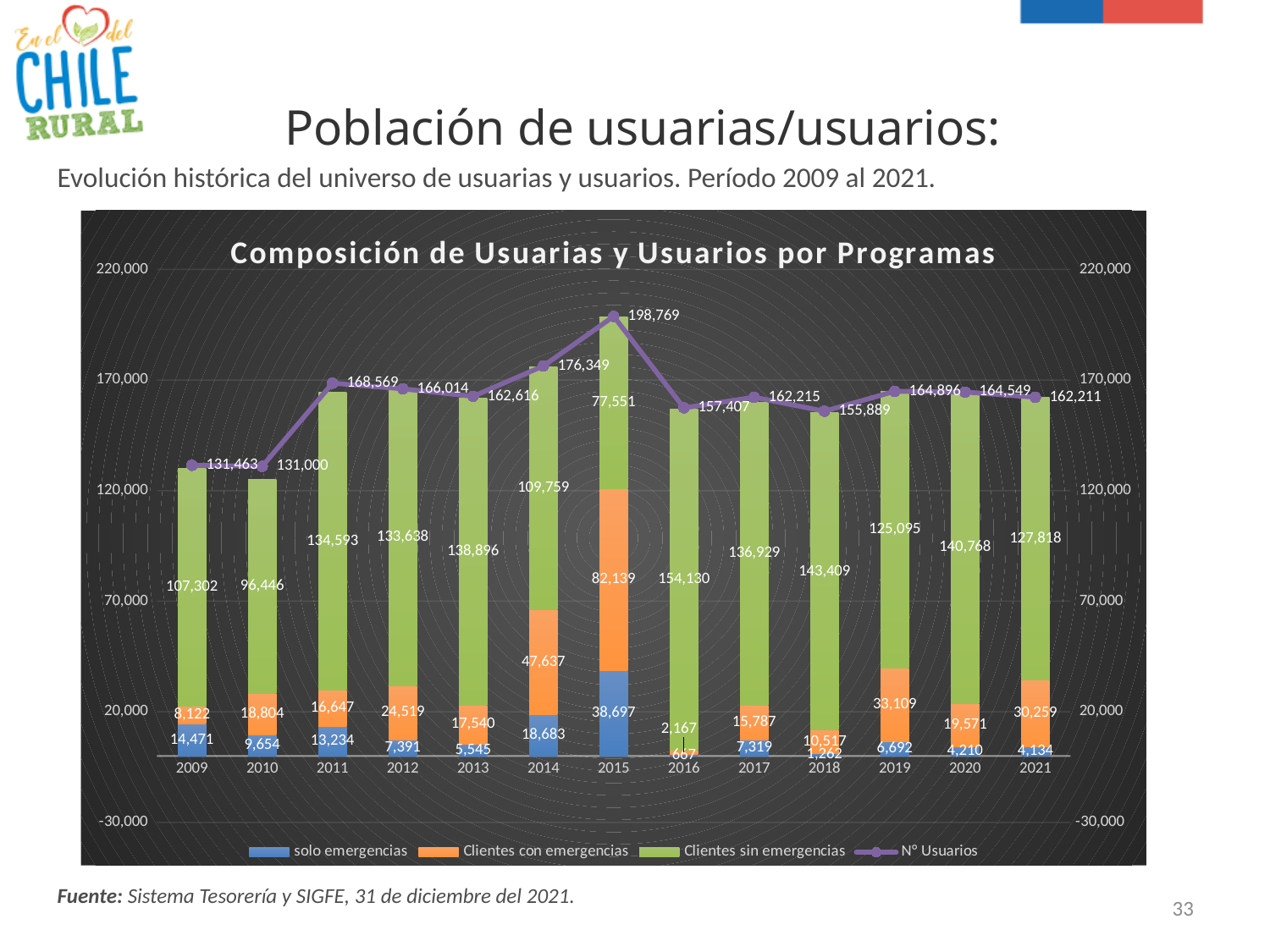
Which year has the larger Clientes con emergencias value, 2019 or 2021? 2019 What is the difference between N° Usuarios in 2015 and in 2014? 22,420 How many series does the legend list? 4 In which year is the Clientes sin emergencias segment smallest? 2015 What is the value of Clientes con emergencias in 2015? 82,139 What is the title of the chart? Composición de Usuarias y Usuarios por Programas What is the value of solo emergencias in 2014? 18,683 What kind of chart is shown? Bar chart with a line In which year is N° Usuarios highest? 2015 What is the N° Usuarios value for 2015? 198,769 What is the value of Clientes sin emergencias in 2016? 154,130 How many years are shown on the x axis? 13